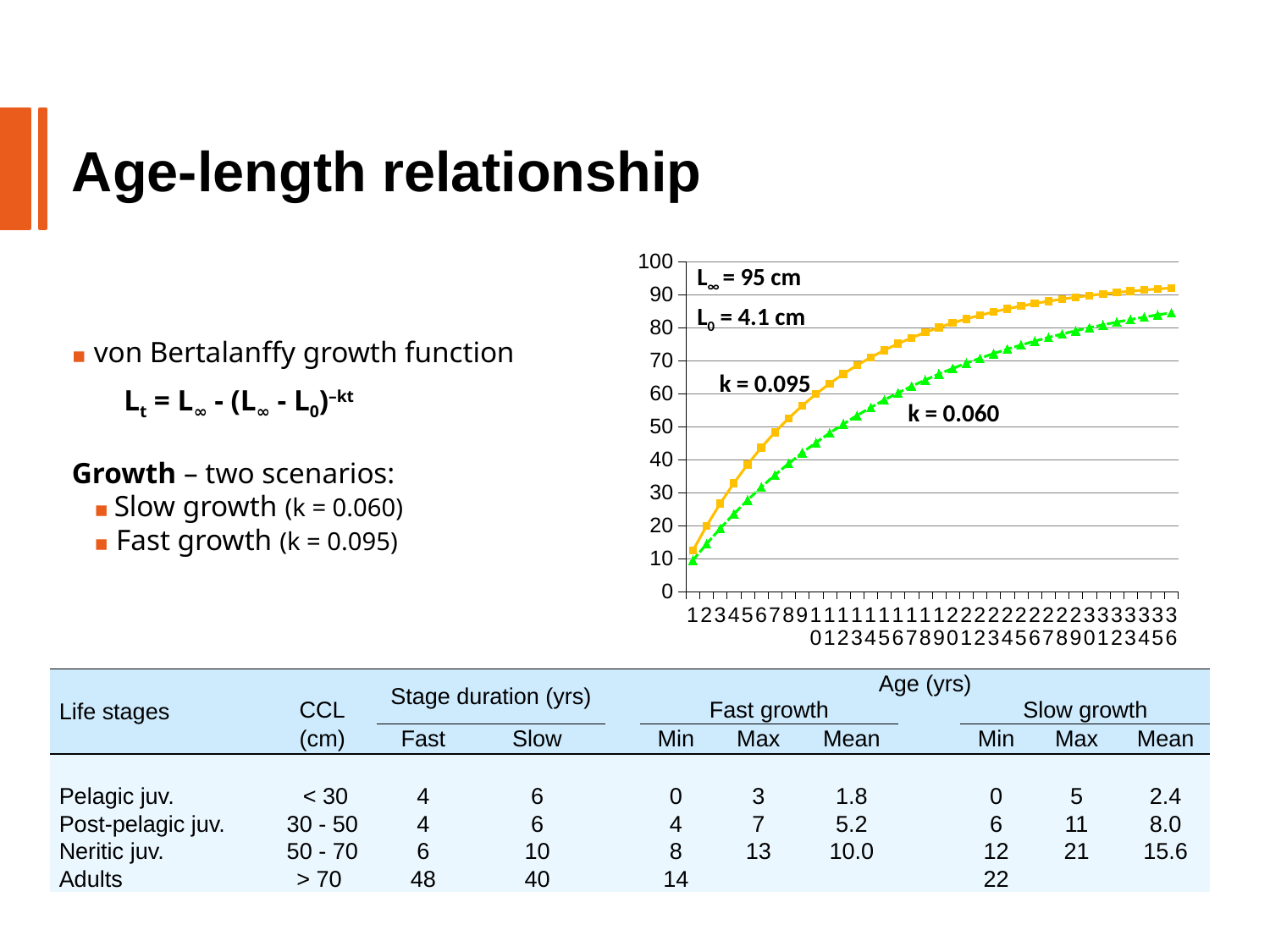
Which curve reaches the highest value at age 36? k = 0.095 Is the value of the k = 0.095 curve at age 3 greater or less than 30? less What value of L∞ is annotated on the chart? 95 cm Do the values on the chart rise or fall as age increases along the x axis? rise At age 10, which curve is higher: k = 0.095 or k = 0.060? k = 0.095 What is the highest value shown on the chart's y axis? 100 Is the value of the k = 0.060 curve at age 10 greater or less than 50? less What kind of chart is shown on the slide? line chart Is the value of the k = 0.060 curve at age 36 greater or less than 80? greater How many growth curves are plotted on the chart? 2